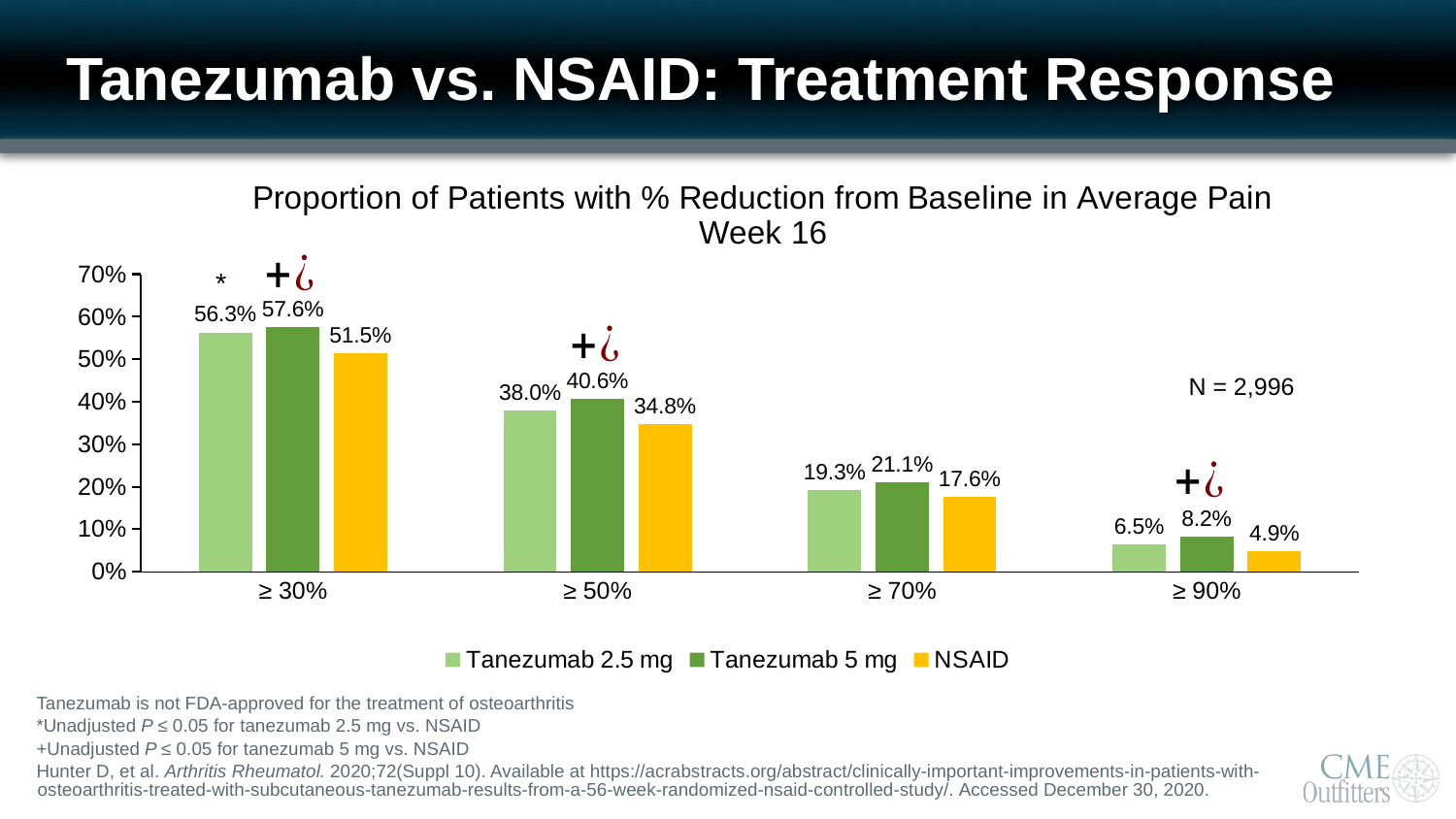
Which series has the lowest value in the ≥ 90% category? NSAID What is the value for Tanezumab 2.5 mg in the ≥ 70% category? 19.3% What is the difference between Tanezumab 5 mg and NSAID in the ≥ 30% category? 6.1% Which series has the highest value in the ≥ 50% category? Tanezumab 5 mg What is the value for NSAID in the ≥ 90% category? 4.9% How many categories are shown on the x axis? 4 Which is larger: Tanezumab 2.5 mg in the ≥ 50% category or NSAID in the ≥ 50% category? Tanezumab 2.5 mg What is the value for Tanezumab 5 mg in the ≥ 30% category? 57.6% What kind of chart is shown on the slide? Bar chart Do the Tanezumab 5 mg values rise or fall from ≥ 30% to ≥ 90%? Fall How many series does the legend list? 3 What is the value for NSAID in the ≥ 50% category? 34.8%